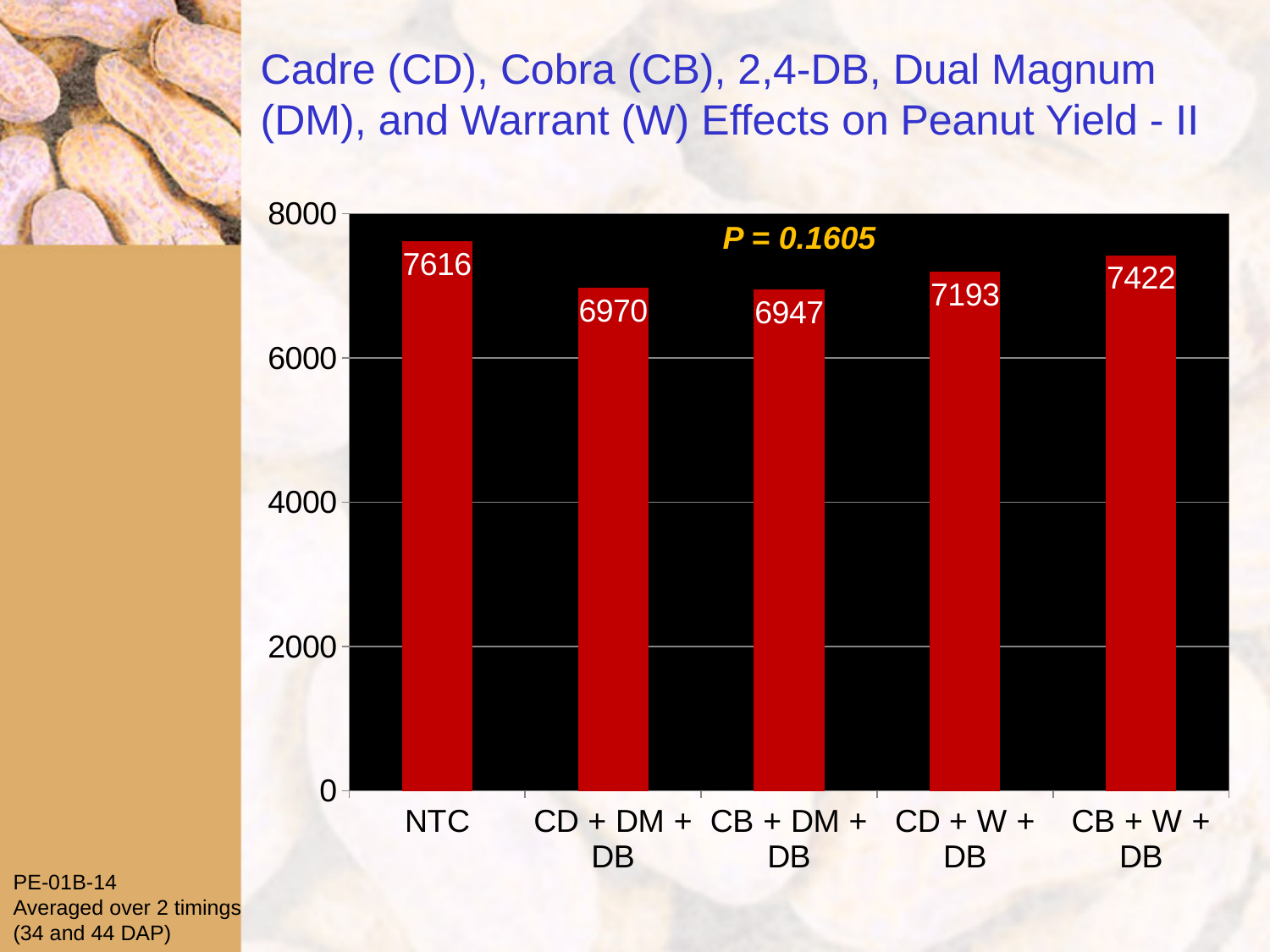
What is the difference between the NTC value and the CD + W + DB value? 423 How many treatments are shown on the x axis? 5 Which treatment has the highest yield? NTC What is the value shown for CD + DM + DB? 6970 What kind of chart is shown on the slide? bar chart Is the value for CB + DM + DB greater or less than 6000? greater Which is larger, the value for CD + W + DB or the value for CB + W + DB? CB + W + DB What is the difference between the CB + W + DB value and the CD + DM + DB value? 452 What is the value shown for CB + W + DB? 7422 Which treatment has the lowest yield? CB + DM + DB What P value is printed on the chart? P = 0.1605 What is the peanut yield value for NTC? 7616